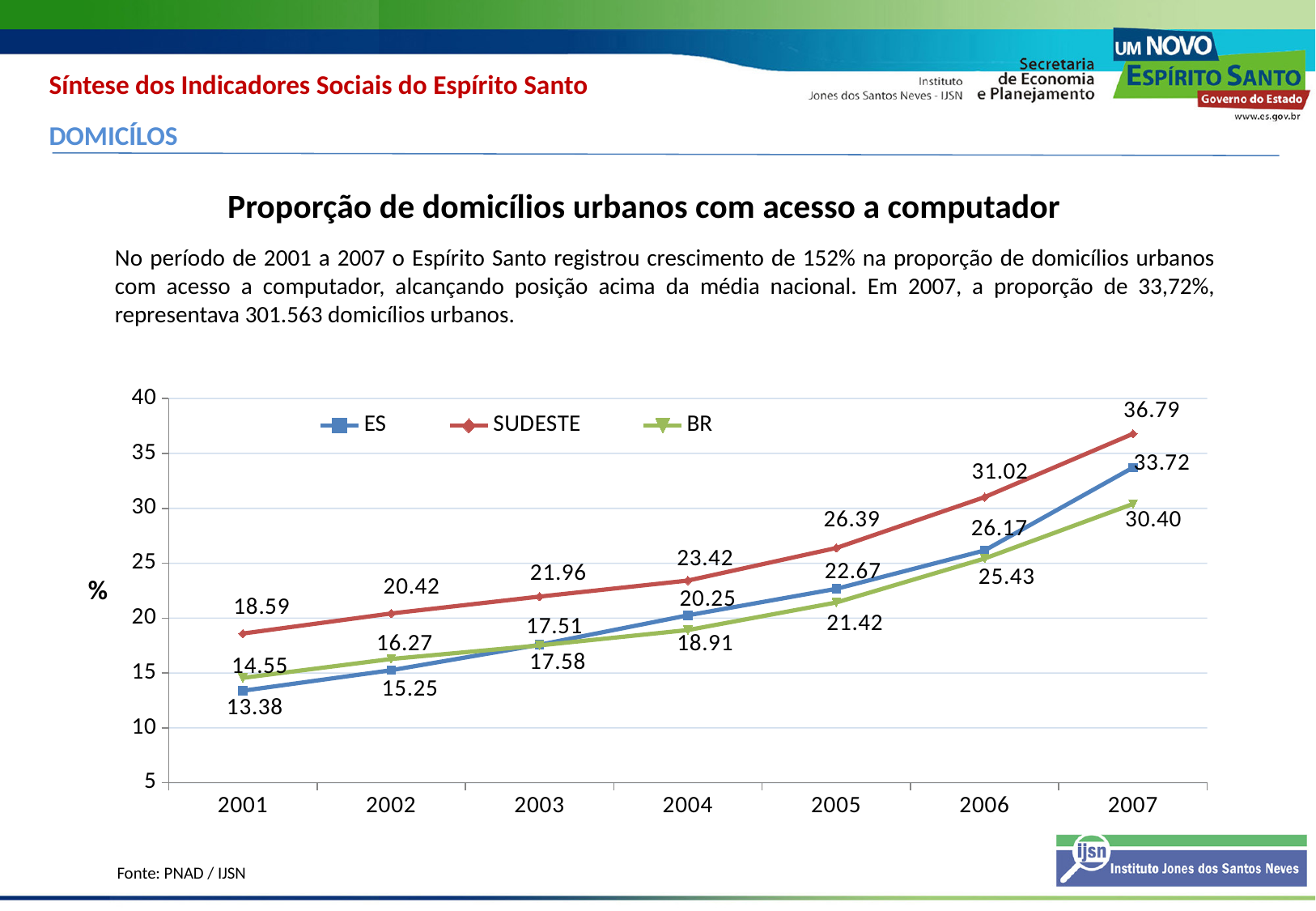
How many years are shown on the x axis? 7 Does the ES series rise or fall from 2001 to 2007? rise Which is larger in 2004, the value for ES or the value for BR? ES What is the value for ES in 2005? 22.67 Which series has the lowest value in 2001? ES Which series has the highest value in 2007? SUDESTE What is the value for SUDESTE in 2007? 36.79 What is the value for BR in 2006? 25.43 What type of chart is shown on the slide? line chart What is the value for ES in 2001? 13.38 How many series does the legend list? 3 What is the difference between the SUDESTE and ES values in 2007? 3.07